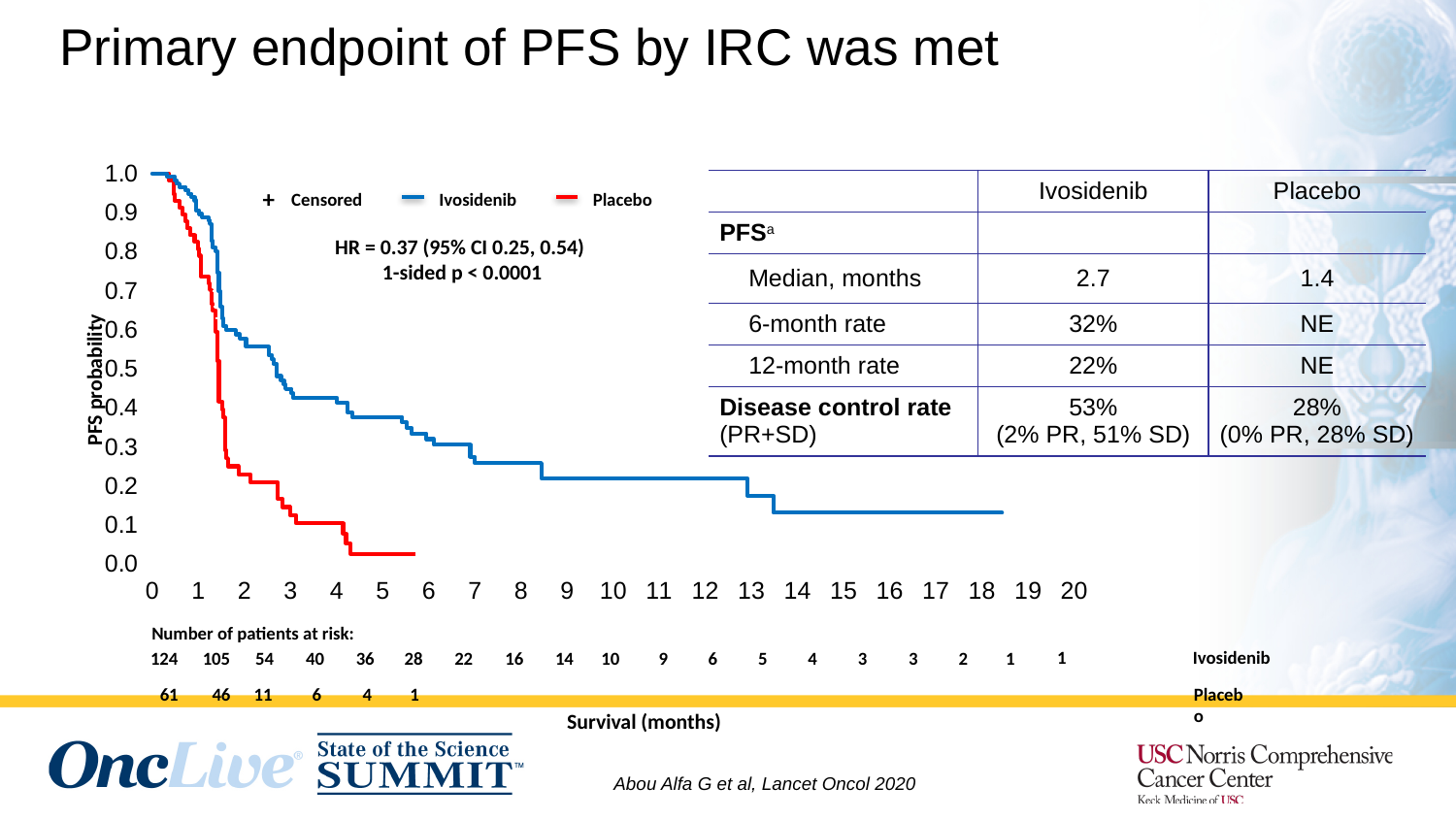
At 6 months, is the PFS probability for Ivosidenib greater or less than 0.5? less How many Placebo patients were at risk at 0 months? 61 What is the difference between the number of Ivosidenib and Placebo patients at risk at 0 months? 63 What kind of chart is shown on the slide? line chart What hazard ratio (HR) is printed on the chart? 0.37 How many Ivosidenib patients were at risk at 0 months? 124 At 3 months, which curve shows the higher PFS probability, Ivosidenib or Placebo? Ivosidenib How many Ivosidenib patients were at risk at 6 months? 22 At 12 months, is the PFS probability for Ivosidenib greater or less than 0.3? less At 2 months, is the PFS probability for Placebo greater or less than 0.5? less Which two treatment groups are plotted as curves in the chart? Ivosidenib and Placebo Does PFS probability rise or fall as survival months increase along the x axis? fall